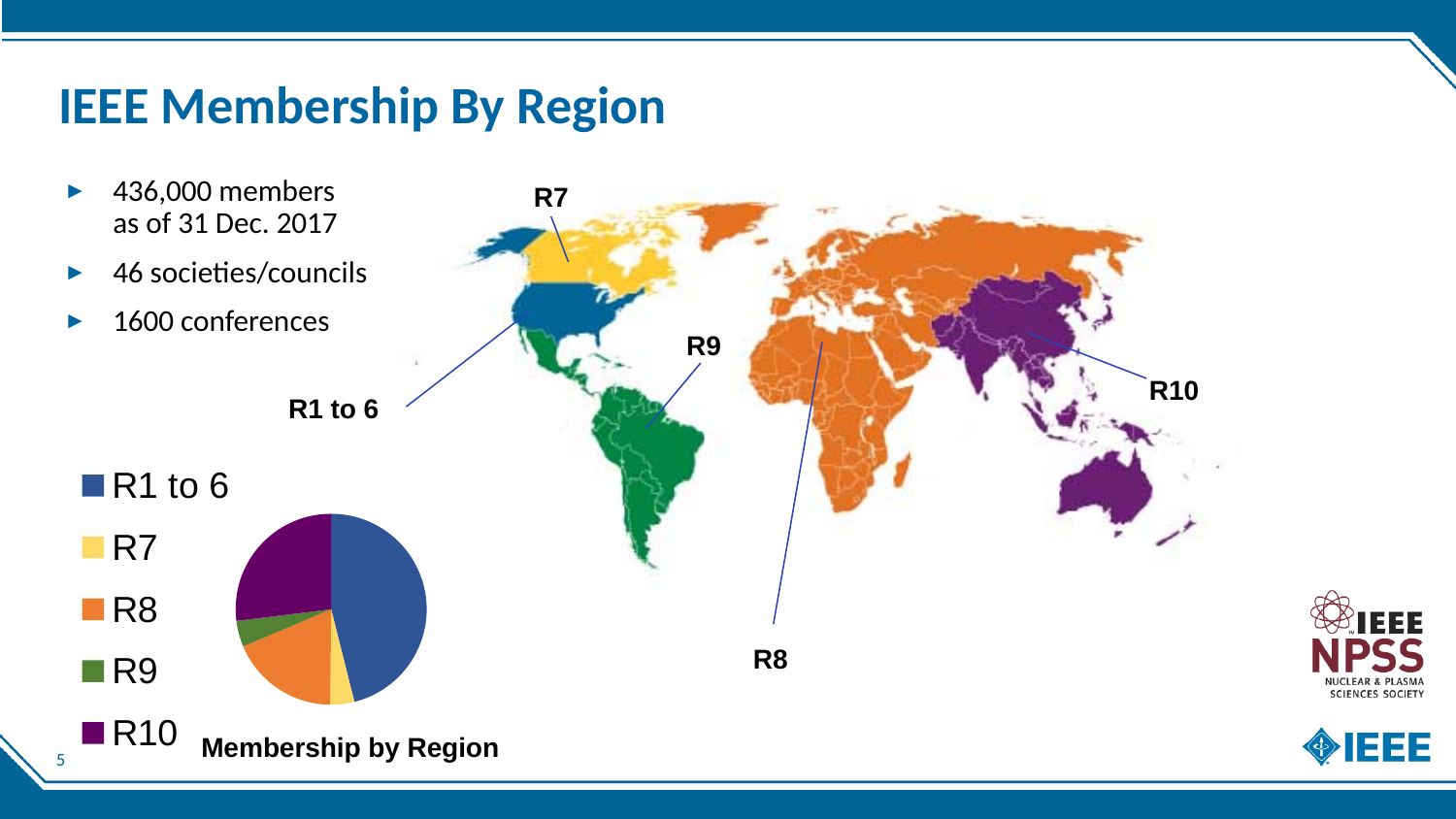
Which slice is larger in the pie chart, R8 or R9? R8 Which region has the largest slice of the pie chart? R1 to 6 How many entries does the pie chart's legend list? 5 Which slice is larger in the pie chart, R8 or R7? R8 Which slice is larger in the pie chart, R10 or R9? R10 What colour represents R10 in the pie chart? purple How many slices does the pie chart have? 5 What is the title of the pie chart? Membership by Region What kind of chart is shown on the slide? pie chart